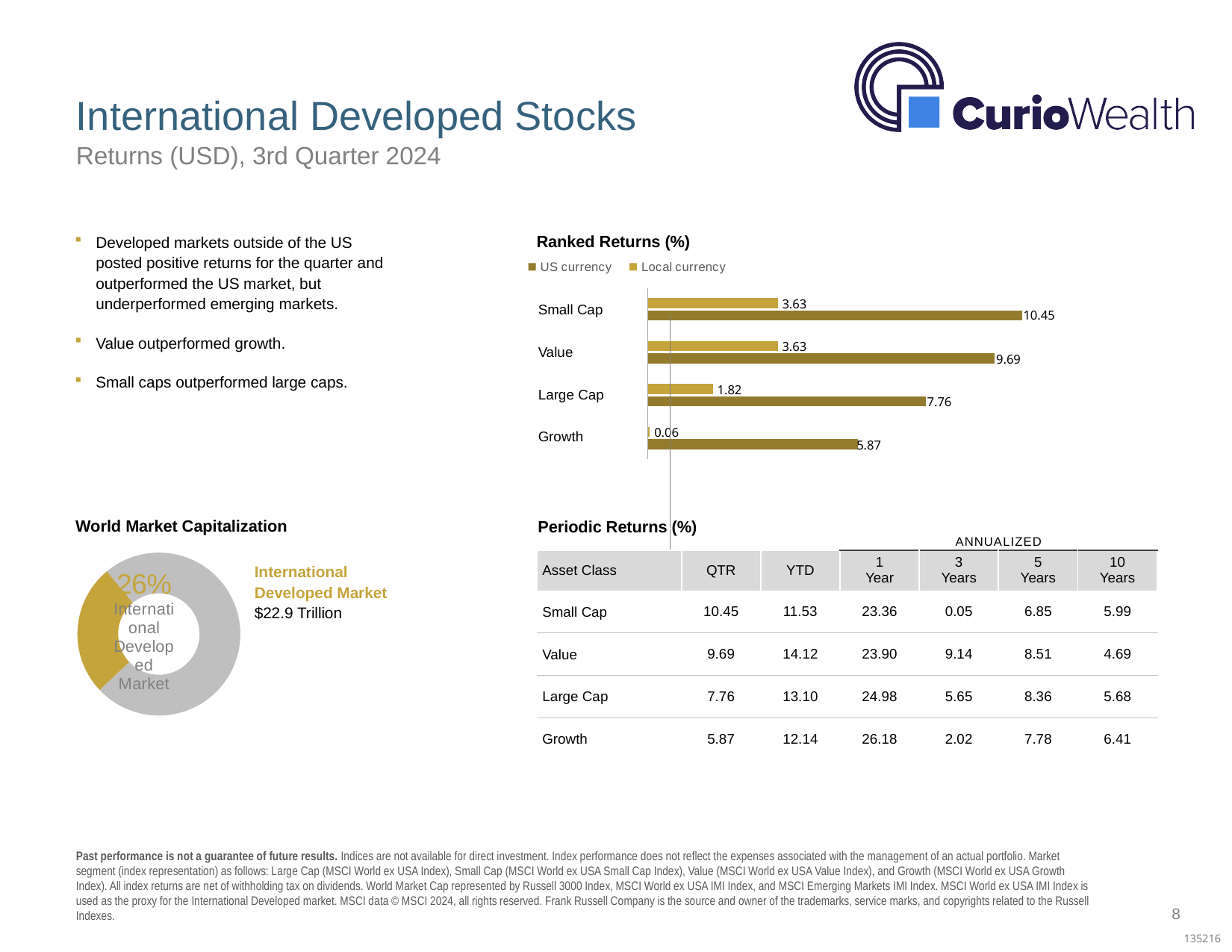
In the Ranked Returns (%) chart, which is larger: the US currency return for Large Cap or for Growth? Large Cap How many series does the legend of the Ranked Returns (%) chart list? 2 What type of chart is the World Market Capitalization chart? Doughnut chart In the Ranked Returns (%) chart, which category has the lowest Local currency return? Growth In the World Market Capitalization chart, what share does the International Developed Market slice represent? 26% In the Ranked Returns (%) chart, which category has the highest US currency return? Small Cap In the Ranked Returns (%) chart, what is the Local currency return for Large Cap? 1.82 In the Ranked Returns (%) chart, what is the Local currency return for Growth? 0.06 What type of chart is the Ranked Returns (%) chart? Bar chart How many categories are shown in the Ranked Returns (%) chart? 4 In the Ranked Returns (%) chart, what is the difference between the US currency returns for Value and Large Cap? 1.93 In the Ranked Returns (%) chart, what is the US currency return for Small Cap? 10.45